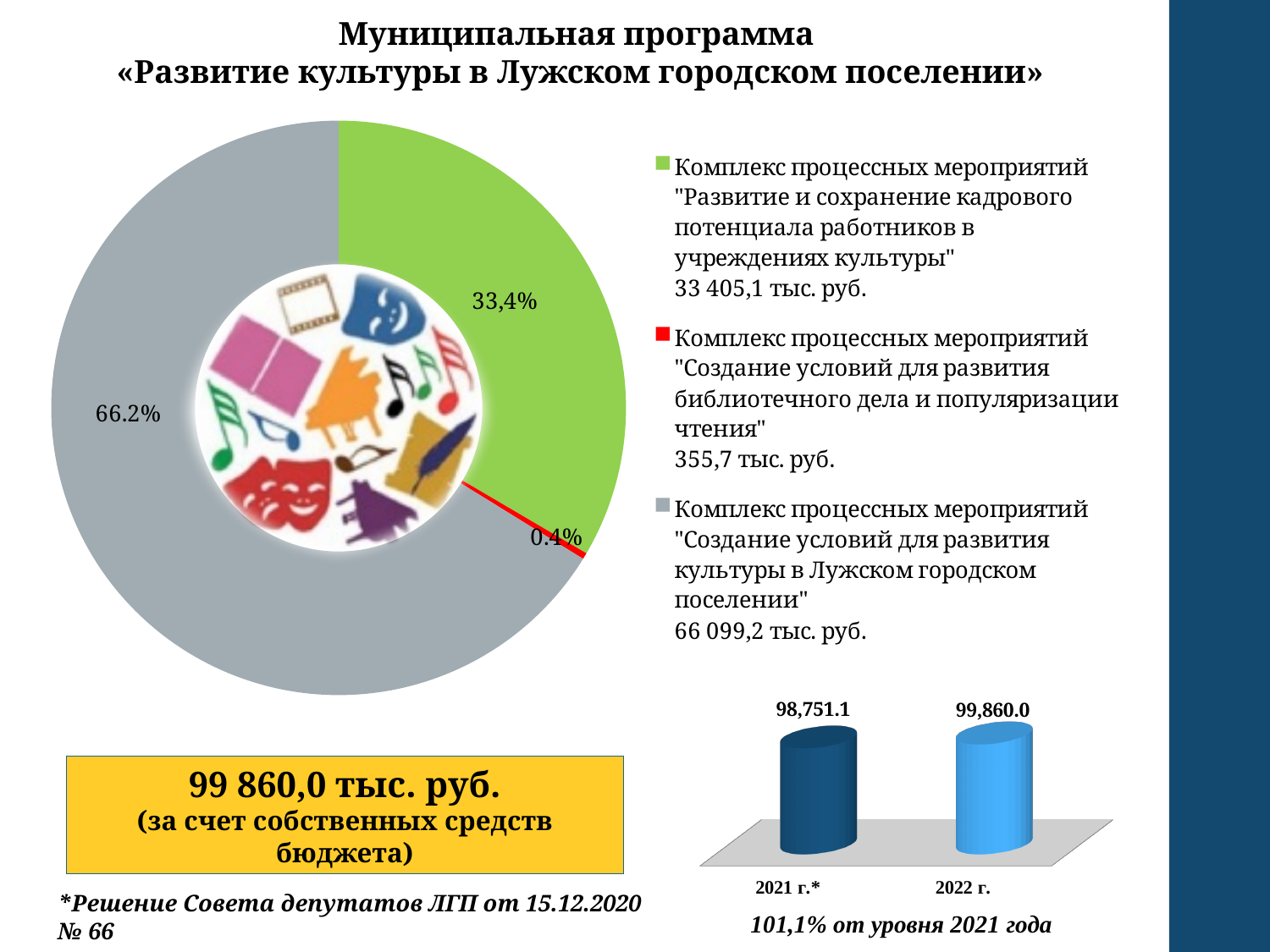
In the bar chart at the bottom right, what is the value for 2022 г.? 99,860.0 In the pie chart, what share is shown for the grey slice ("Создание условий для развития культуры в Лужском городском поселении")? 66.2% What kind of chart is shown at the bottom right of the slide? Bar chart In the bar chart at the bottom right, what is the value for 2021 г.*? 98,751.1 According to the legend of the pie chart, what amount is given for "Создание условий для развития библиотечного дела и популяризации чтения"? 355,7 тыс. руб. In the pie chart, what share is shown for the red slice ("Создание условий для развития библиотечного дела и популяризации чтения")? 0.4% In the pie chart, which category has the largest slice? Создание условий для развития культуры в Лужском городском поселении In the pie chart, which category has the smallest slice? Создание условий для развития библиотечного дела и популяризации чтения In the pie chart, what share is shown for the green slice ("Развитие и сохранение кадрового потенциала работников в учреждениях культуры")? 33,4% In the bar chart at the bottom right, what is the difference between the 2022 г. value and the 2021 г.* value? 1,108.9 How many slices does the pie chart have? 3 In the bar chart at the bottom right, which year has the larger value, 2021 г.* or 2022 г.? 2022 г.